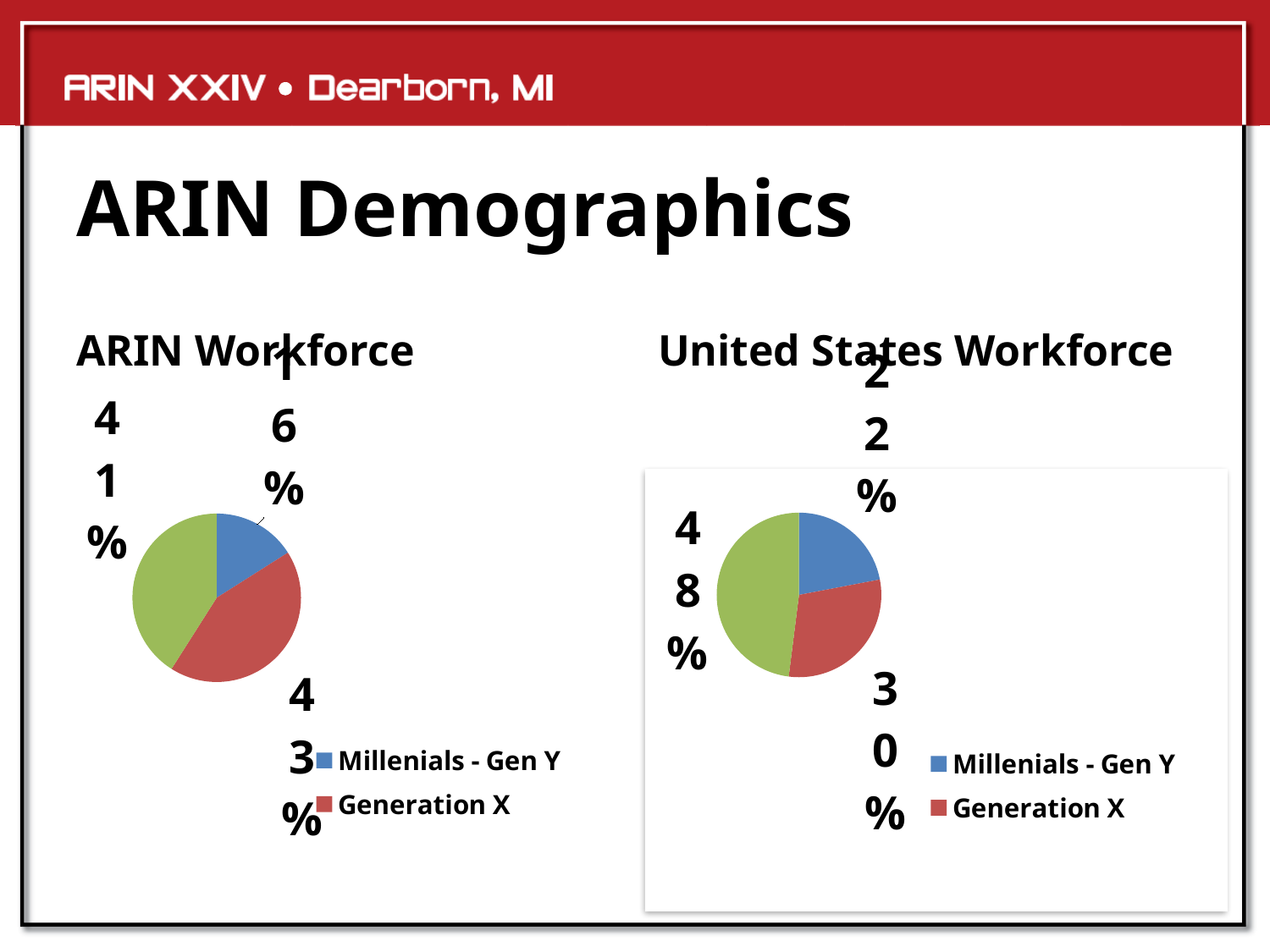
Which chart shows a larger share for Millenials - Gen Y: ARIN Workforce or United States Workforce? United States Workforce In the ARIN Workforce chart, what percentage is shown for Generation X? 43% In the ARIN Workforce chart, what is the difference between the Generation X share and the Millenials - Gen Y share? 27 percentage points In the ARIN Workforce chart, what colour represents Generation X? Red In the United States Workforce chart, what percentage is shown for Generation X? 30% How many slices does the United States Workforce pie chart have? 3 In the ARIN Workforce chart, which is larger: Millenials - Gen Y or Generation X? Generation X In the United States Workforce chart, what percentage is shown for Millenials - Gen Y? 22% In the United States Workforce chart, what is the difference between the Generation X share and the Millenials - Gen Y share? 8 percentage points What kind of chart is the ARIN Workforce chart? Pie chart In the ARIN Workforce chart, what percentage is shown for Millenials - Gen Y? 16% How many entries does the legend of the United States Workforce chart list? 2